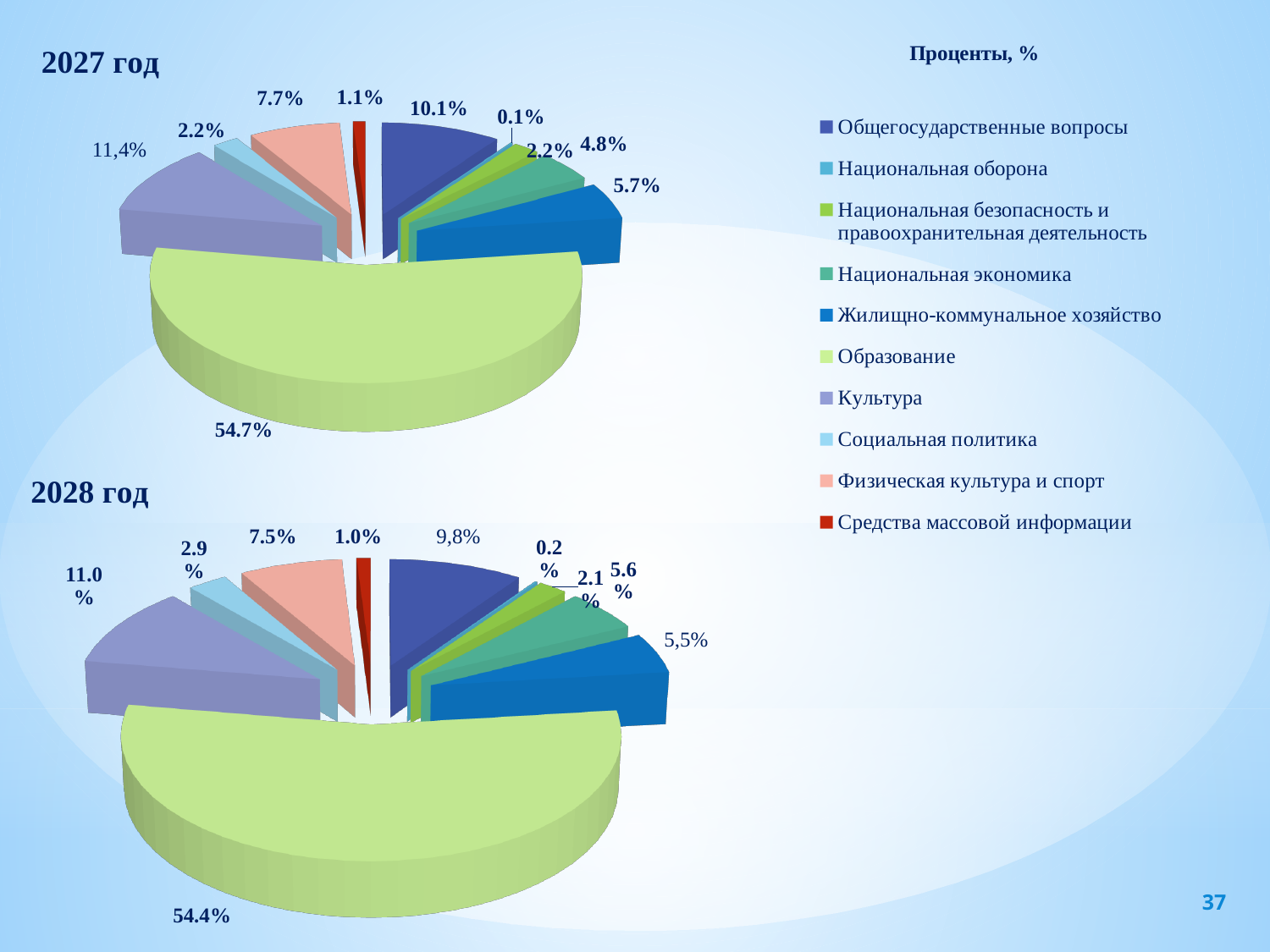
In the 2027 год chart, what is the value for Средства массовой информации? 1.1% What type of chart is used for 2027 год? Pie chart In the 2028 год chart, what is the value for Физическая культура и спорт? 7.5% In the 2028 год chart, which is larger: Общегосударственные вопросы or Культура? Культура What is the difference between the Образование share in the 2027 год chart and in the 2028 год chart? 0.3% In the 2028 год chart, what share does Образование have? 54.4% In the 2027 год chart, which category has the smallest slice? Национальная оборона In the 2027 год chart, what share does Образование have? 54.7% In the 2027 год chart, what is the value for Культура? 11,4% How many categories does the legend list? 10 In the 2028 год chart, which category has the smallest slice? Национальная оборона In the 2027 год chart, which category has the largest slice? Образование